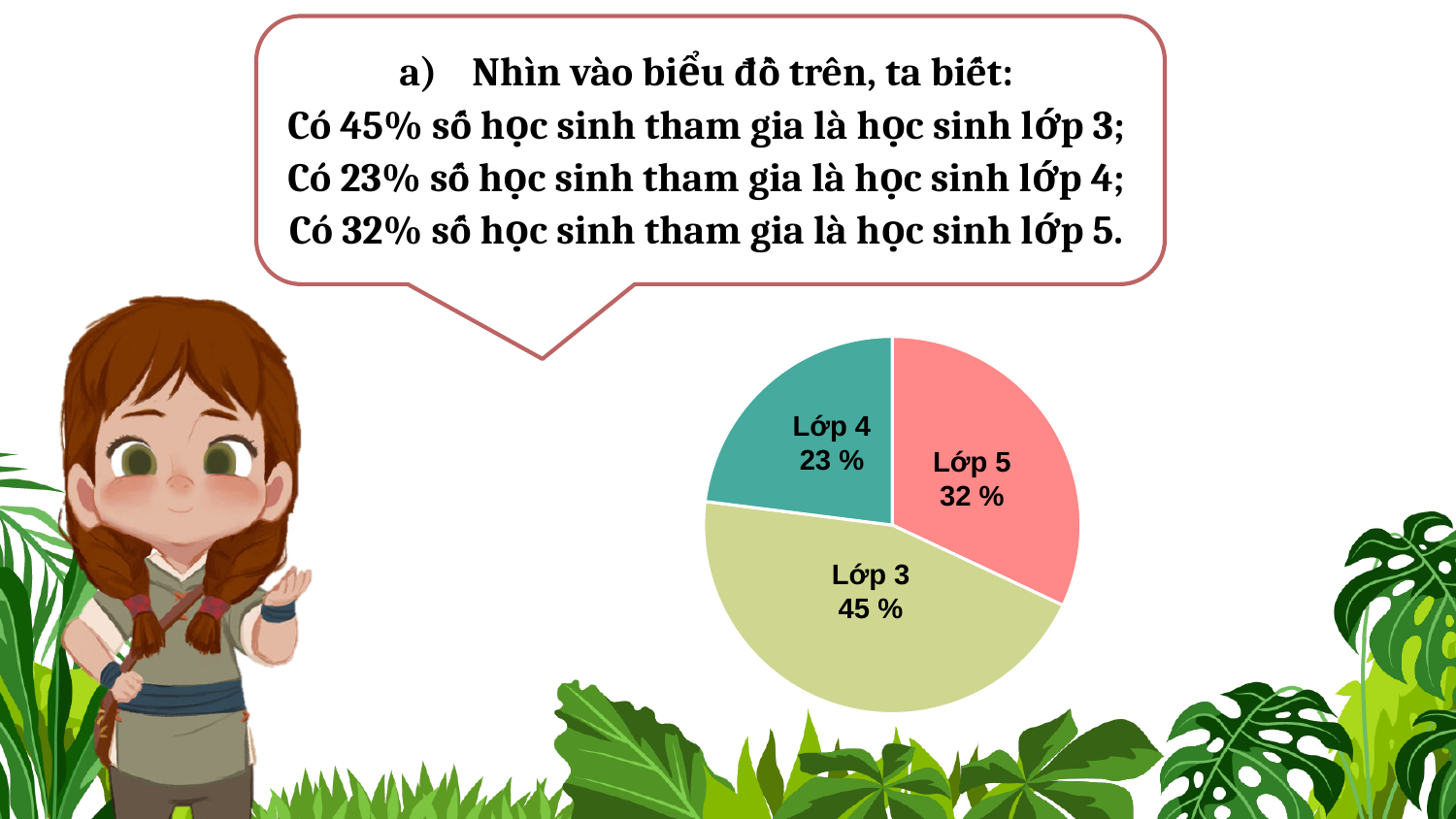
What share of the pie does Lớp 4 have? 23 % What colour is the Lớp 5 slice of the pie chart? pink How many slices does the pie chart have? 3 Which slice of the pie chart is the largest? Lớp 3 What share of the pie does Lớp 5 have? 32 % Which is larger, the share for Lớp 5 or the share for Lớp 4? Lớp 5 What share of the pie does Lớp 3 have? 45 % Which slice of the pie chart is the smallest? Lớp 4 What colour is the Lớp 4 slice of the pie chart? teal What is the difference in percentage points between the Lớp 3 slice and the Lớp 5 slice? 13 What is the difference in percentage points between the Lớp 5 slice and the Lớp 4 slice? 9 What kind of chart is shown on the slide? pie chart